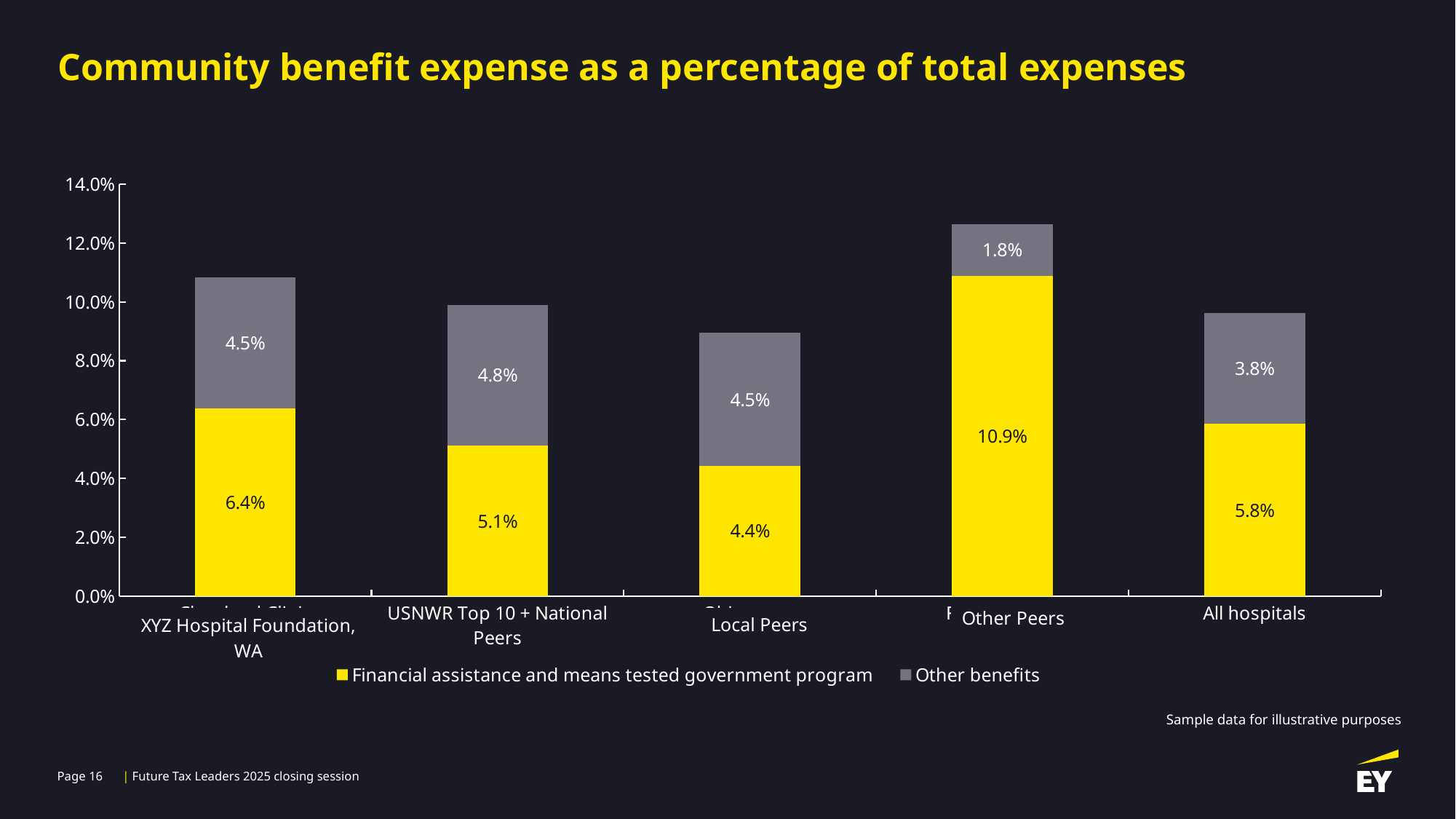
What kind of chart is shown on the slide? Stacked bar chart What is the Financial assistance and means tested government program value for Other Peers? 10.9% Which category has the highest Financial assistance and means tested government program value? Other Peers Which is larger: the Other benefits value for USNWR Top 10 + National Peers or for All hospitals? USNWR Top 10 + National Peers How many categories are shown on the x axis? 5 What is the Financial assistance and means tested government program value for XYZ Hospital Foundation, WA? 6.4% How many series does the legend list? 2 Which category has the lowest Other benefits value? Other Peers What is the total of the stacked bar for XYZ Hospital Foundation, WA? 10.9% What is the Other benefits value for All hospitals? 3.8% What is the difference between the Financial assistance and means tested government program values for Other Peers and Local Peers? 6.5% What is the total of the stacked bar for Other Peers? 12.7%